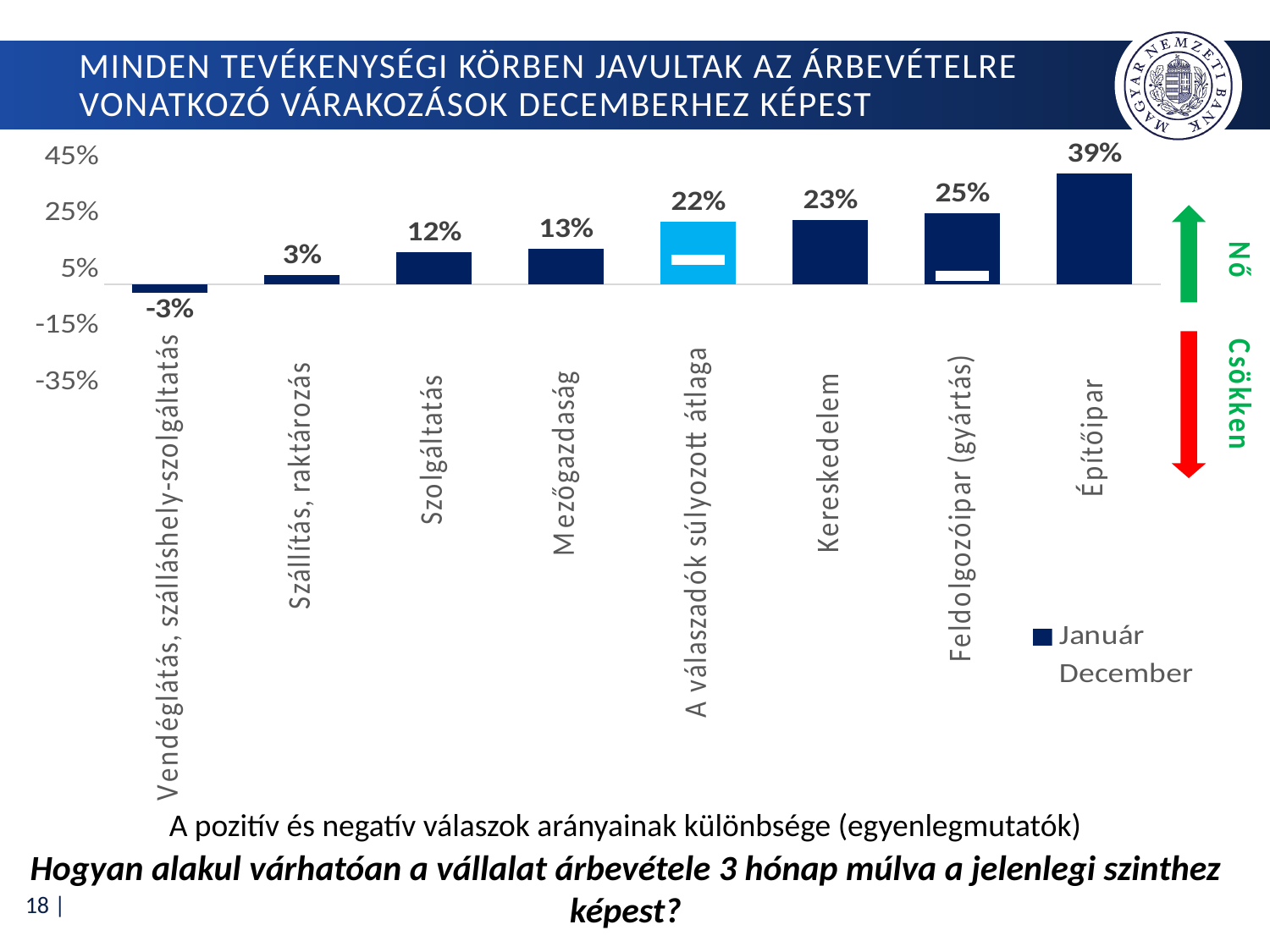
What is the January value for Építőipar? 39% Which category has the lowest January value? Vendéglátás, szálláshely-szolgáltatás How many series does the legend list? 2 What kind of chart is shown on the slide? Bar chart How many categories are shown on the x axis? 8 Which has a larger January value, Szolgáltatás or Kereskedelem? Kereskedelem What is the difference between the January values for Építőipar and Feldolgozóipar (gyártás)? 14% What is the January value for Mezőgazdaság? 13% Which series is shown in dark blue according to the legend? Január Which category has the highest January value? Építőipar What is the January value for A válaszadók súlyozott átlaga? 22% What is the January value for Vendéglátás, szálláshely-szolgáltatás? -3%